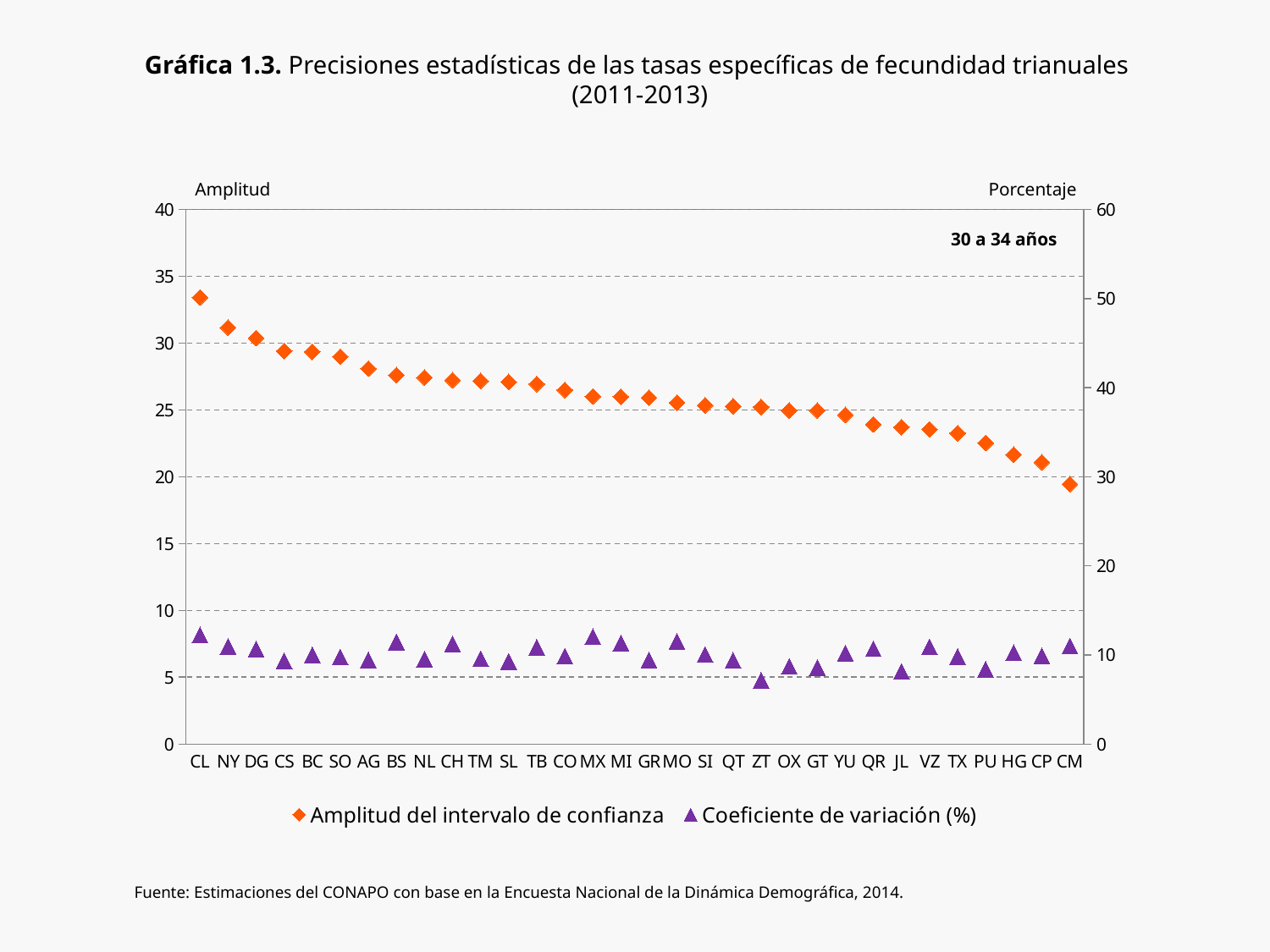
Do the Amplitud del intervalo de confianza values rise or fall from CL to CM along the x axis? fall Is the Amplitud del intervalo de confianza value for CL greater or less than 30? greater Which category has the lowest value for Amplitud del intervalo de confianza? CM Which category has the lowest value for Coeficiente de variación (%)? ZT Which category has the highest value for Amplitud del intervalo de confianza? CL How many categories are shown on the x axis? 32 What age group is indicated in the label inside the plot area? 30 a 34 años Which has a larger Amplitud del intervalo de confianza, NY or YU? NY Is the Amplitud del intervalo de confianza value for MX greater or less than 30? less How many series does the legend list? 2 What is the label of the right-hand vertical axis? Porcentaje Is the Amplitud del intervalo de confianza value for HG greater or less than 25? less